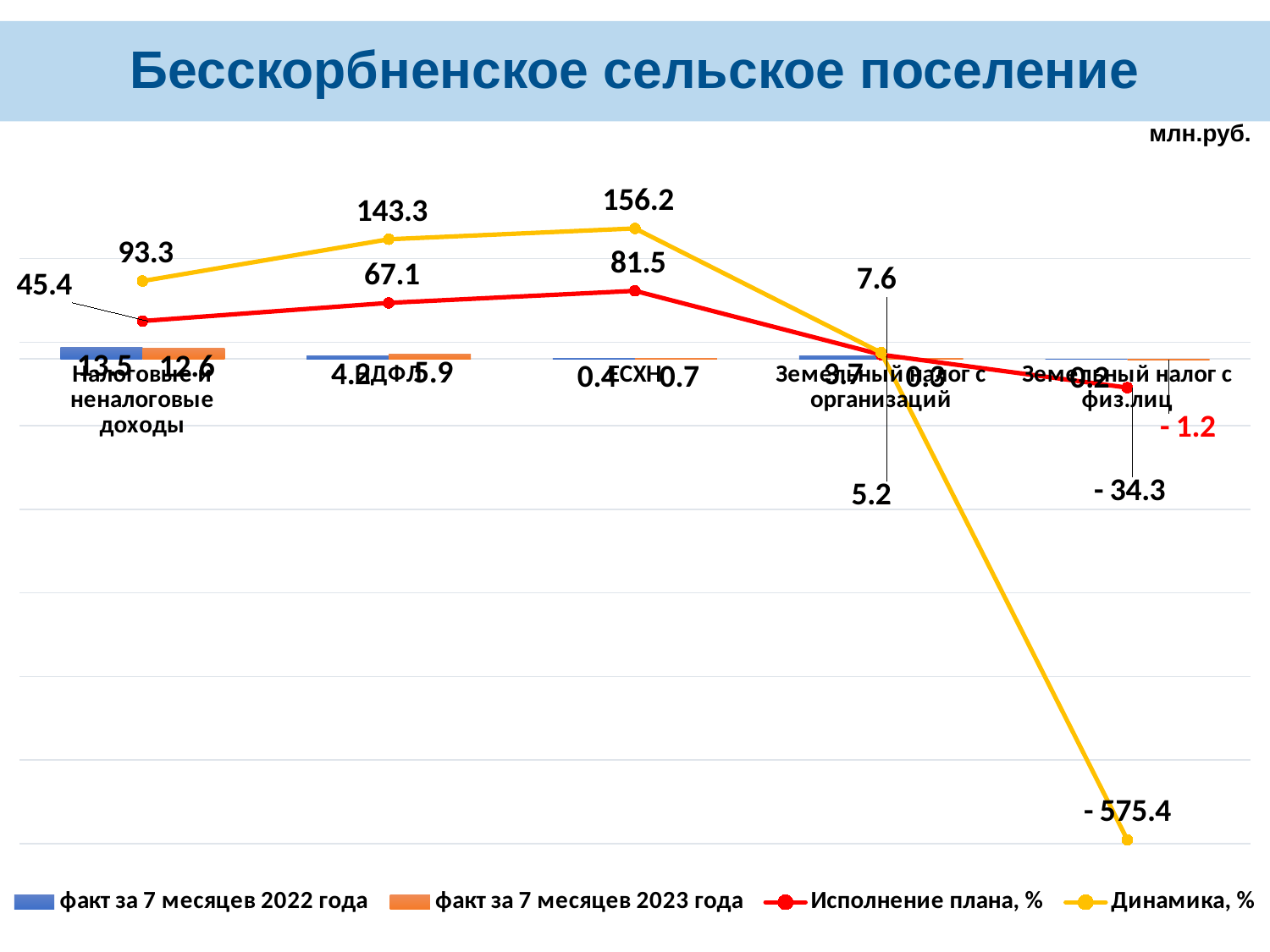
What is the value of Динамика, % for НДФЛ? 143.3 Which category has the highest value of Динамика, %? ЕСХН What is the value of факт за 7 месяцев 2023 года for НДФЛ? 5.9 What is the value of Исполнение плана, % for ЕСХН? 81.5 What kind of chart is shown on the slide? A combined bar and line chart Which has a higher Исполнение плана, %: НДФЛ or Налоговые и неналоговые доходы? НДФЛ How many categories are shown along the x axis? 5 What is the value of факт за 7 месяцев 2022 года for Налоговые и неналоговые доходы? 13.5 Which category has the lowest value of Динамика, %? Земельный налог с физ.лиц What is the value of Динамика, % for Земельный налог с физ.лиц? - 575.4 How many series does the legend list? 4 What is the difference between the Динамика, % values for ЕСХН and НДФЛ? 12.9